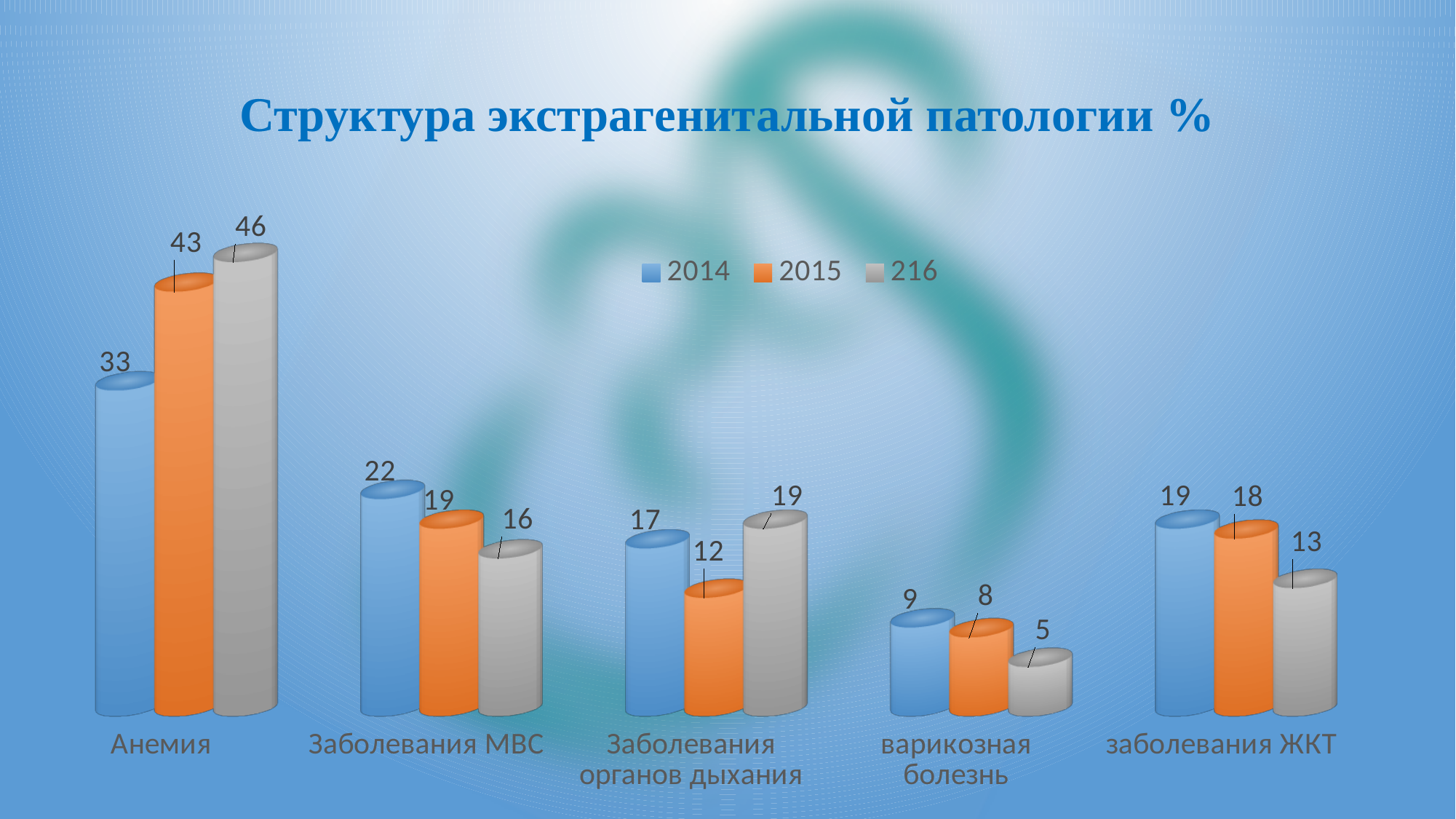
How many series does the legend list? 3 What is the value for Анемия in the 2014 series? 33 Which category has the lowest value in the series labelled 216? варикозная болезнь What is the difference between the 216 and 2014 values for Анемия? 13 Which is larger for Заболевания МВС: the 2014 value or the 216 value? 2014 What kind of chart is shown on the slide? Bar chart What is the value for заболевания ЖКТ in the series labelled 216? 13 What is the title of the chart? Структура экстрагенитальной патологии % What is the value for Заболевания органов дыхания in the 2015 series? 12 Do the values for варикозная болезнь rise or fall from the 2014 series to the 216 series? Fall How many categories are shown on the x axis? 5 Which category has the highest value in the 2014 series? Анемия